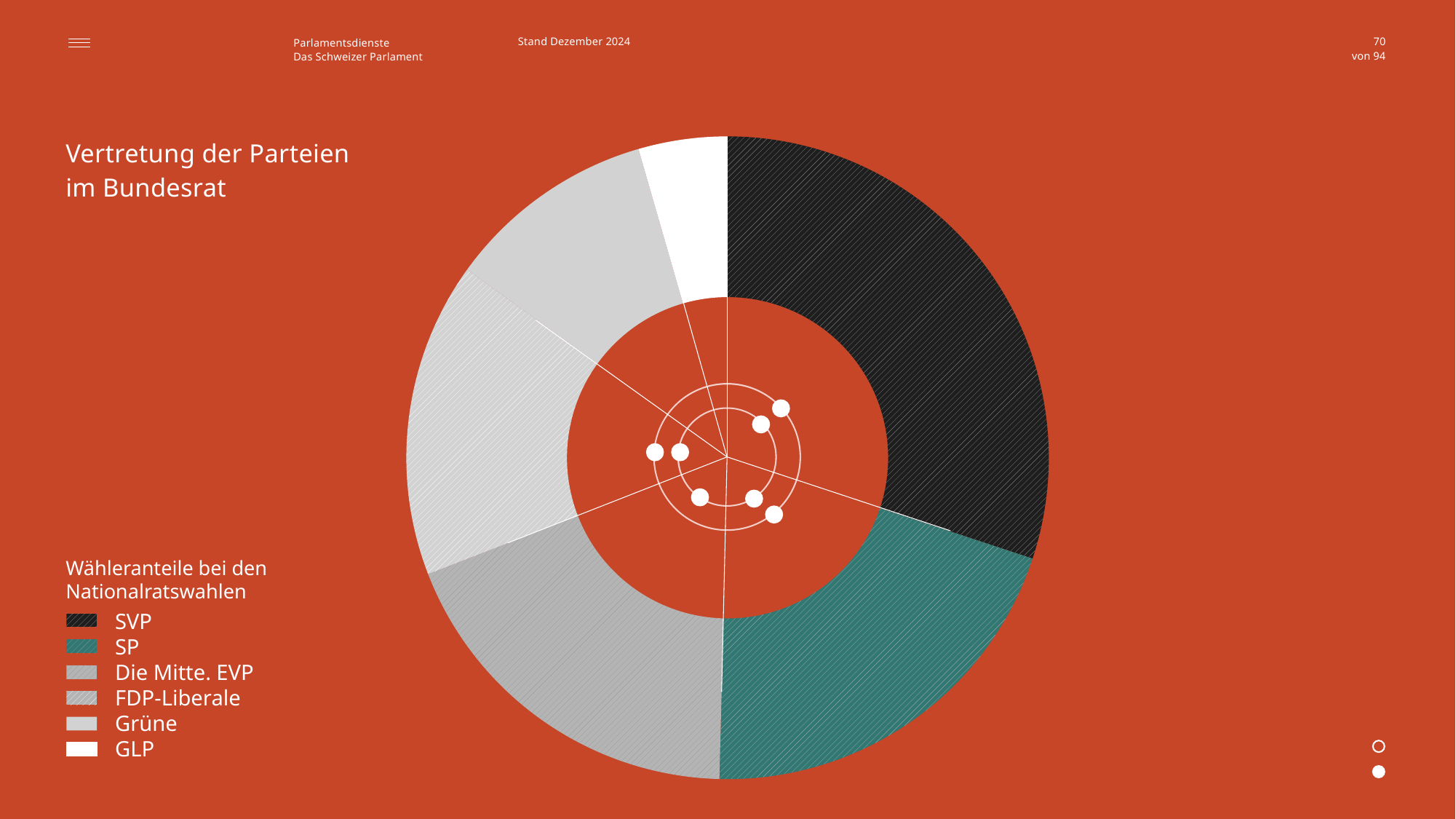
Which slice is larger, SP or Grüne? SP How many parties does the legend list? 6 What is the title of the chart? Vertretung der Parteien im Bundesrat Which party has the smallest slice in the chart? GLP What colour is the SVP slice in the chart? Black What kind of chart is shown on the slide? Pie chart (donut) How many slices does the donut chart have? 6 Which party has the largest slice in the chart? SVP Which slice is larger, SVP or SP? SVP Which slice is larger, GLP or Die Mitte. EVP? Die Mitte. EVP